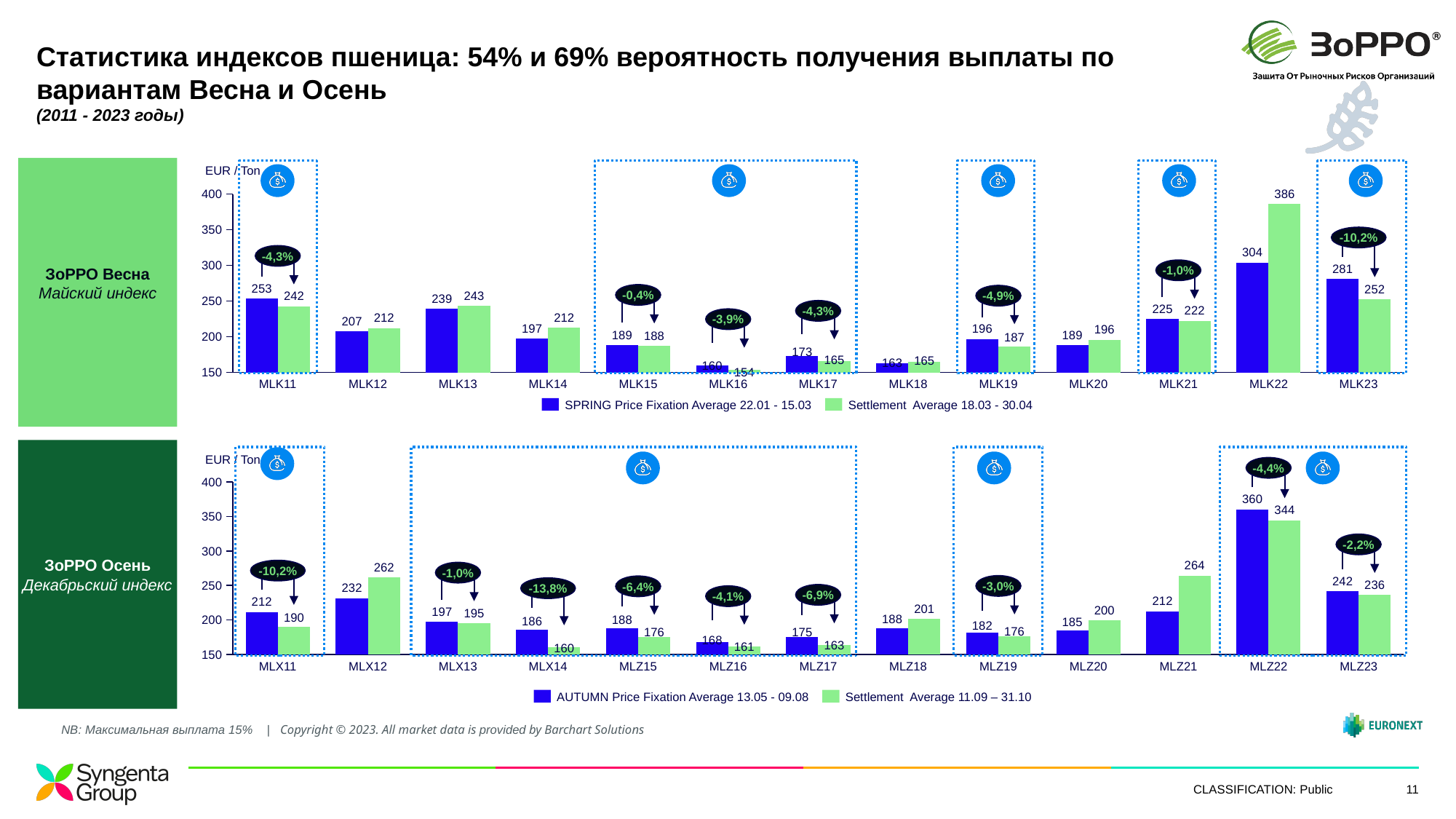
In the bottom chart (ЗоРРО Осень), which category has the lowest Settlement Average value? MLX14 In the top chart (ЗоРРО Весна), what is the Settlement Average value for MLK23? 252 In the bottom chart (ЗоРРО Осень), what is the difference between the AUTUMN Price Fixation Average and the Settlement Average for MLX11? 22 In the top chart (ЗоРРО Весна), how many categories are shown on the x axis? 13 In the bottom chart (ЗоРРО Осень), which is larger for MLX12: the AUTUMN Price Fixation Average or the Settlement Average? Settlement Average In the bottom chart (ЗоРРО Осень), what is the Settlement Average value for MLZ21? 264 In the bottom chart (ЗоРРО Осень), what is the AUTUMN Price Fixation Average value for MLZ22? 360 In the top chart (ЗоРРО Весна), what is the SPRING Price Fixation Average value for MLK22? 304 In the top chart (ЗоРРО Весна), what is the difference between the Settlement Average and the SPRING Price Fixation Average for MLK22? 82 How many series does the legend of the bottom chart (ЗоРРО Осень) list? 2 What type of chart is the top chart (ЗоРРО Весна)? Bar chart In the top chart (ЗоРРО Весна), which category has the highest Settlement Average value? MLK22